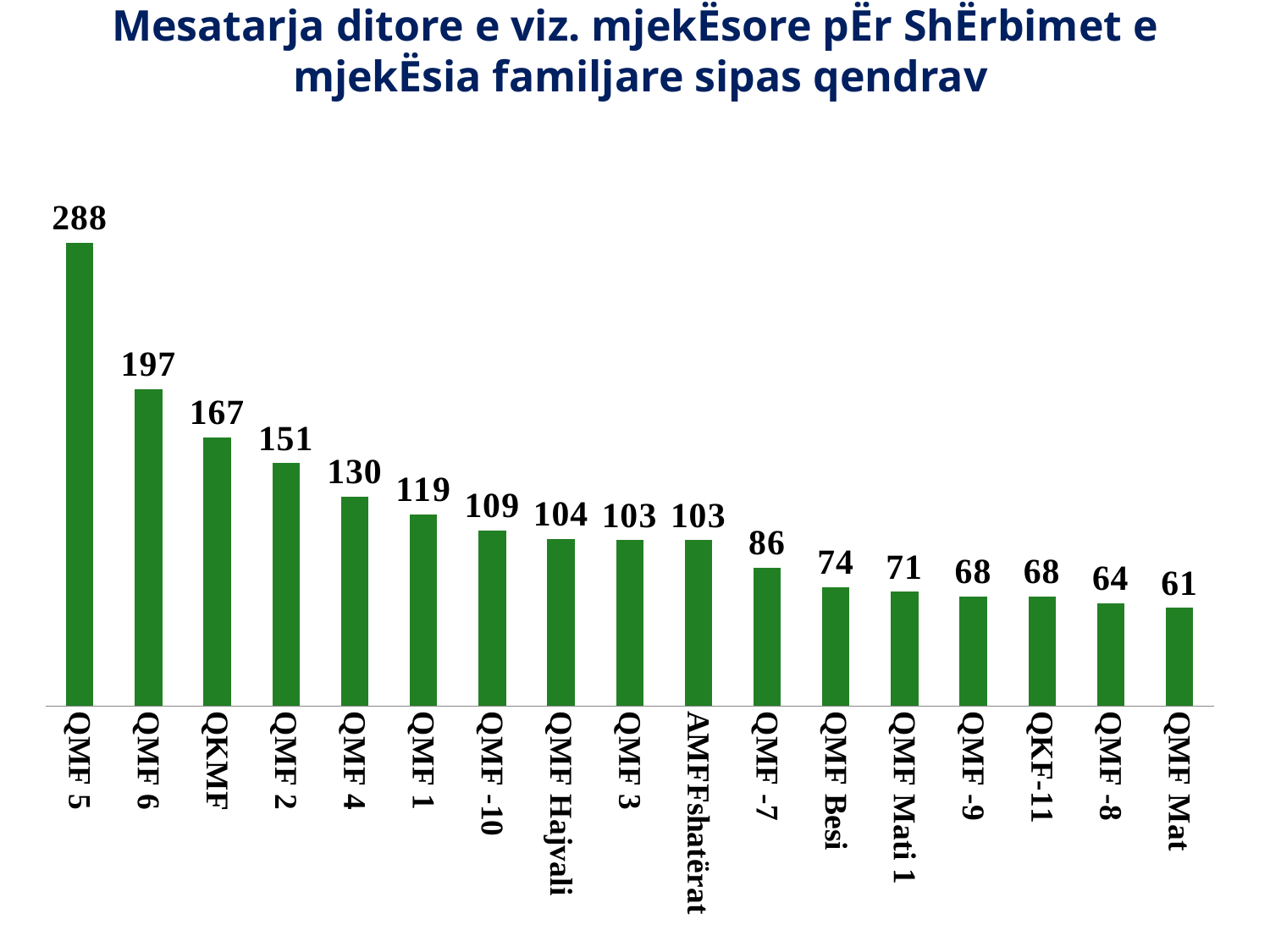
What is the value for QMF Besi? 74 Which is larger, the value for QMF 2 or the value for QMF 4? QMF 2 What is the difference between the values for QMF 6 and QKMF? 30 Which category has the lowest value? QMF Mat What kind of chart is shown on the slide? bar chart How many categories are shown in the chart? 17 Do the values rise or fall from left to right along the x axis? fall What is the value for QKF-11? 68 What is the value for QMF 5? 288 Which category has the highest value? QMF 5 What is the difference between the values for QMF 5 and QMF Mat? 227 What is the value for QMF Hajvali? 104